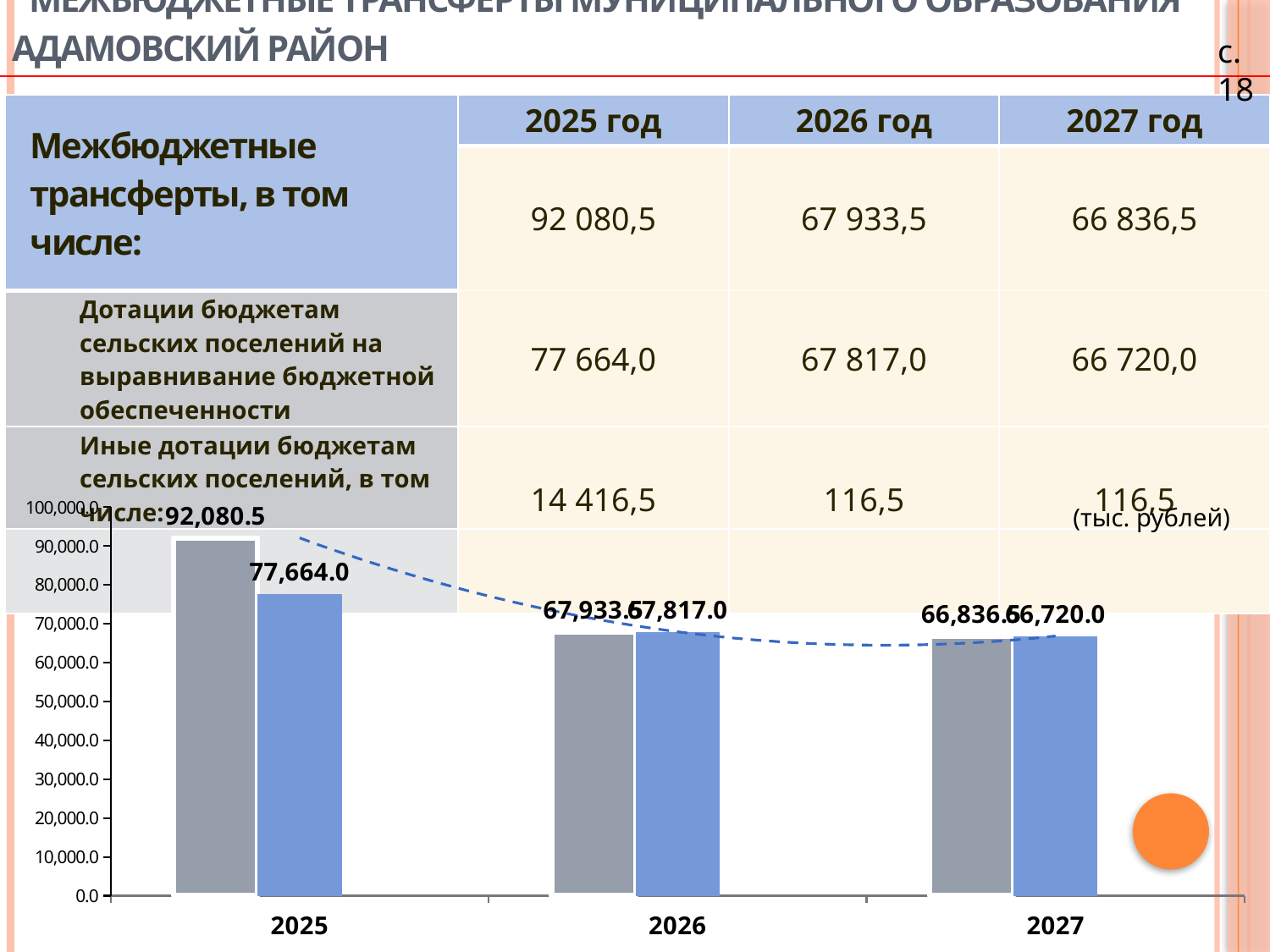
What is the difference between the gray bar and the blue bar for 2025? 14,416.5 What is the value labelled on the blue bar for 2025? 77,664.0 What is the highest tick value shown on the vertical axis of the chart? 100,000.0 What is the value labelled on the gray bar for 2025? 92,080.5 How many year categories are shown on the x axis of the bar chart? 3 Do the gray bar values rise or fall from 2025 to 2027? fall What type of chart is shown at the bottom of the slide? bar chart What is the value labelled on the blue bar for 2027? 66,720.0 Which is larger for 2025: the gray bar or the blue bar? the gray bar What is the value labelled on the gray bar for 2026? 67,933.5 Which year has the highest gray bar in the chart? 2025 Which year has the lowest blue bar in the chart? 2027